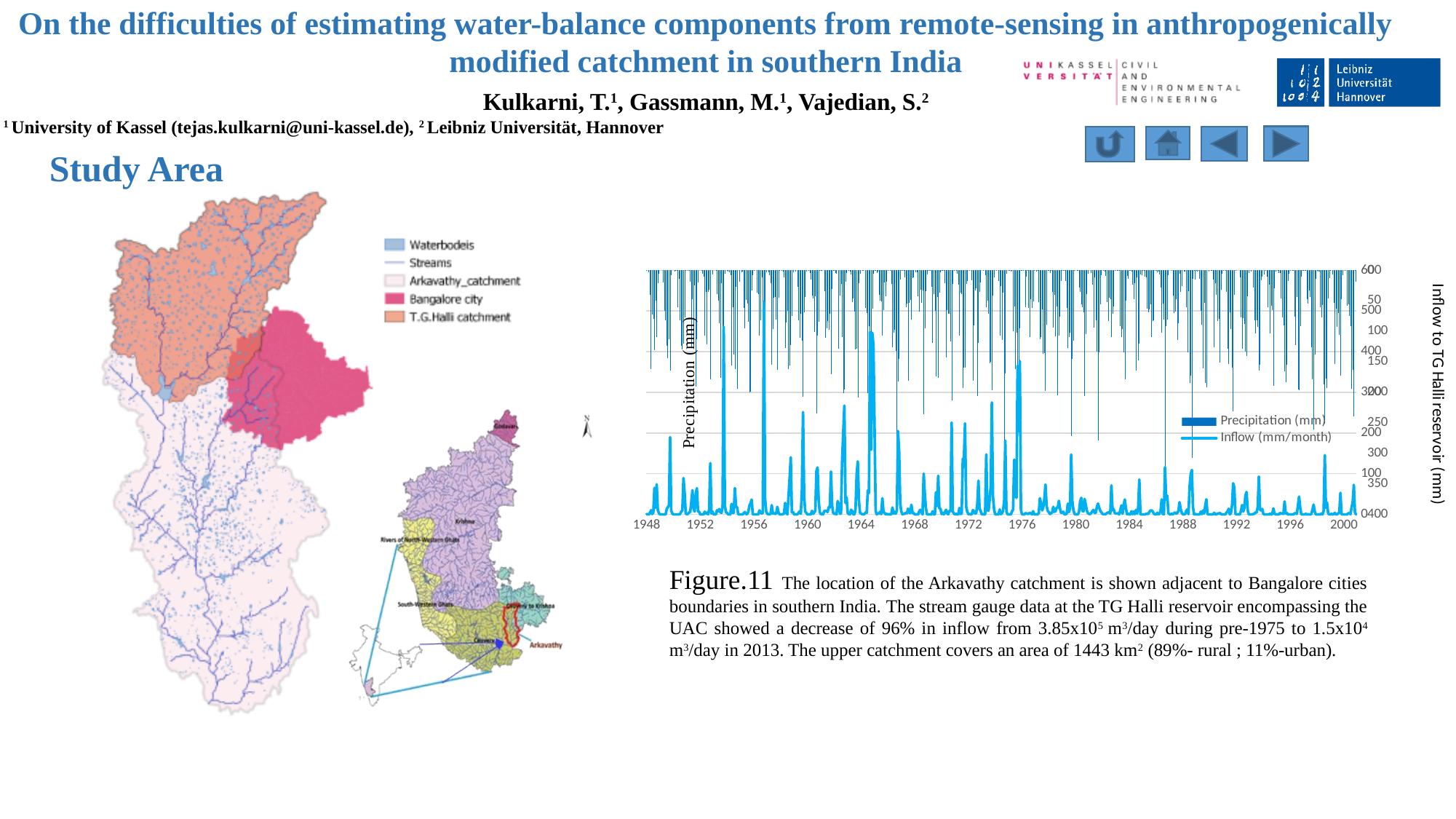
Which series in the chart is drawn as a line? Inflow (mm/month) Is the inflow peak around 1965 greater or less than 300 on the right-hand axis? greater What are the two series named in the chart's legend? Precipitation (mm) and Inflow (mm/month) Is the inflow value around 1998 greater or less than 100 on the right-hand axis? greater Does the inflow series generally rise or fall from 1948 to 2000? Fall How many year labels are printed along the x axis of the chart? 14 Which period shows larger inflow peaks in the chart, before 1976 or after 1976? Before 1976 What kind of chart is used to show the data on the slide? A combined bar and line chart What is the title of the right-hand vertical axis of the chart? Inflow to TG Halli reservoir (mm) What is the last year labelled on the x axis of the chart? 2000 What is the first year shown on the x axis of the chart? 1948 How many series does the legend of the chart list? 2